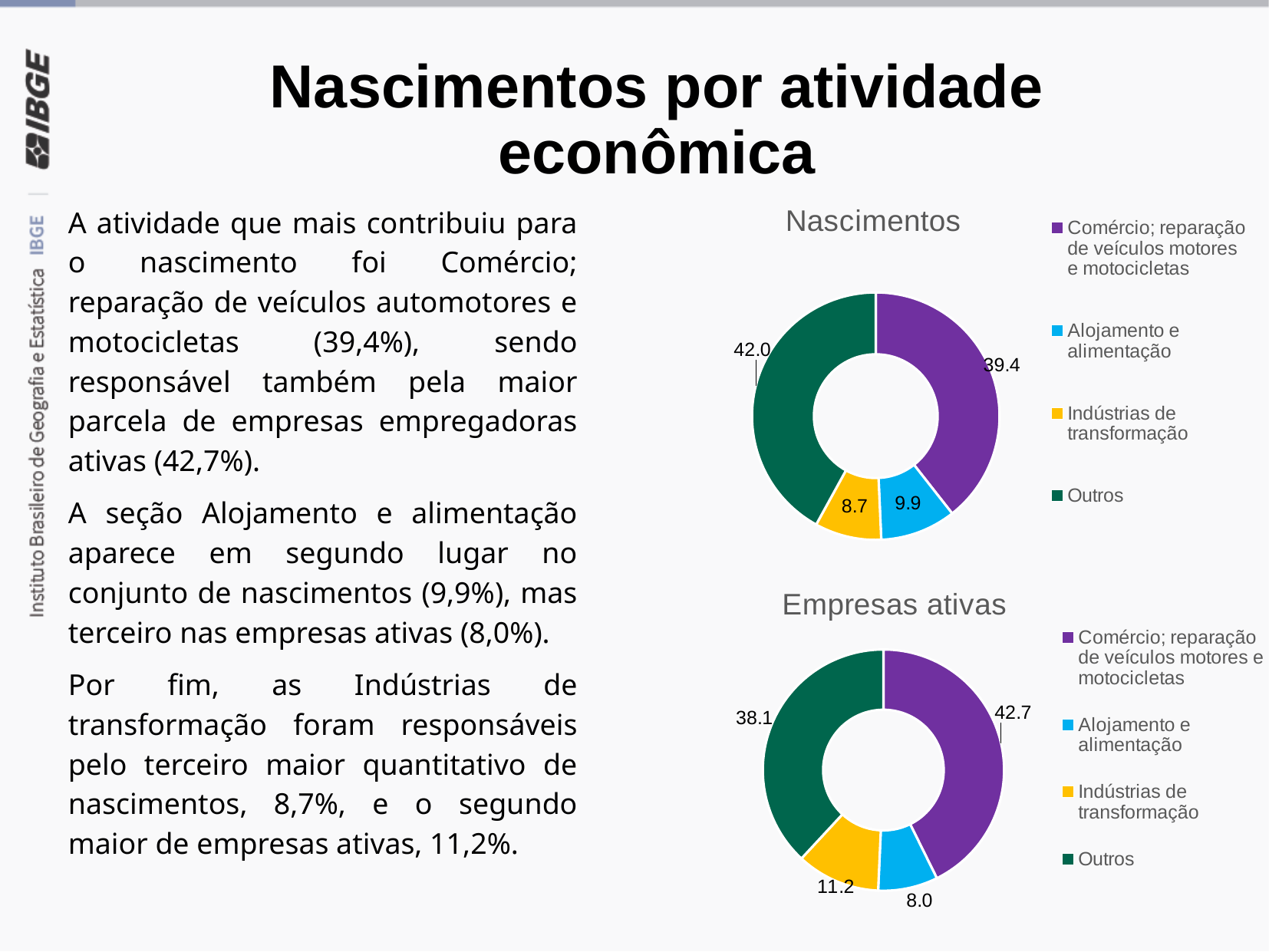
What type of chart is the 'Nascimentos' chart? Doughnut chart In the 'Empresas ativas' chart, what is the value for Outros? 38.1 How many categories does the 'Empresas ativas' chart show? 4 In the 'Empresas ativas' chart, what is the value for Indústrias de transformação? 11.2 In the 'Nascimentos' chart, what is the value for Alojamento e alimentação? 9.9 In the 'Nascimentos' chart, which category has the largest value? Outros In the 'Empresas ativas' chart, which category has the smallest value? Alojamento e alimentação In the 'Nascimentos' chart, which is larger: the value for Alojamento e alimentação or the value for Indústrias de transformação? Alojamento e alimentação In the 'Nascimentos' chart, which category has the smallest value? Indústrias de transformação In the 'Empresas ativas' chart, what is the difference between the values for Comércio; reparação de veículos motores e motocicletas and Outros? 4.6 In the 'Nascimentos' chart, what is the value for Comércio; reparação de veículos motores e motocicletas? 39.4 In the 'Empresas ativas' chart, which category has the largest value? Comércio; reparação de veículos motores e motocicletas